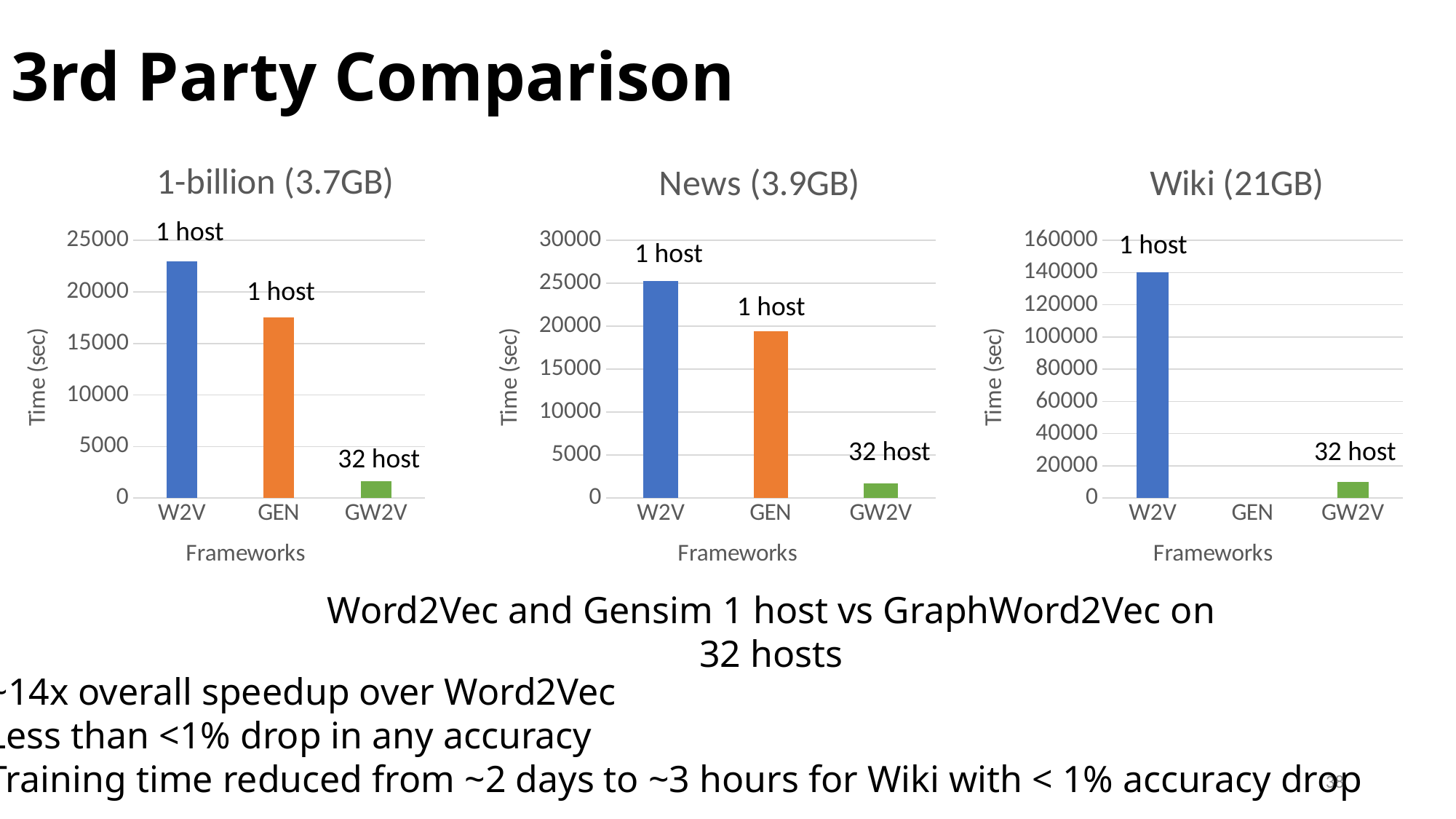
In the Wiki (21GB) chart, is the value for GW2V greater or less than 20000? less In the News (3.9GB) chart, which is larger, the value for GEN or the value for GW2V? GEN In the News (3.9GB) chart, is the value for GW2V greater or less than 5000? less In the 1-billion (3.7GB) chart, is the value for GEN greater or less than 15000? greater How many frameworks are listed on the x axis of the Wiki (21GB) chart? 3 In the News (3.9GB) chart, which framework has the highest time? W2V What kind of chart is the News (3.9GB) chart? bar chart In the 1-billion (3.7GB) chart, which framework has the highest time? W2V What is the y-axis label of the 1-billion (3.7GB) chart? Time (sec) In the 1-billion (3.7GB) chart, which framework has the lowest time? GW2V